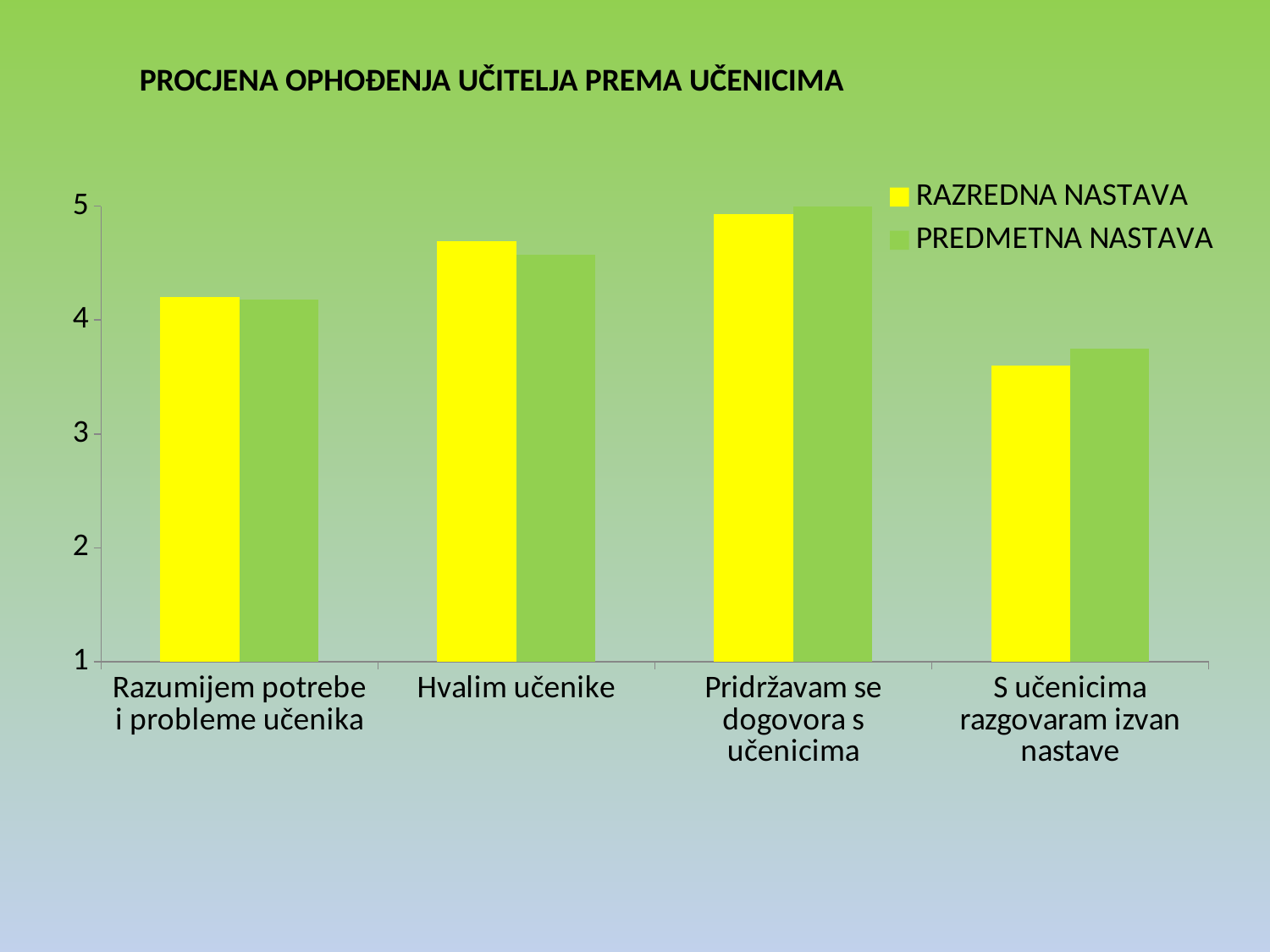
For 'S učenicima razgovaram izvan nastave', which series has the larger value, RAZREDNA NASTAVA or PREDMETNA NASTAVA? PREDMETNA NASTAVA For the RAZREDNA NASTAVA series, which category has the lowest value? S učenicima razgovaram izvan nastave How many categories are shown on the x axis of the chart? 4 How many series does the legend list? 2 For 'Hvalim učenike', which series has the larger value, RAZREDNA NASTAVA or PREDMETNA NASTAVA? RAZREDNA NASTAVA Which series is shown in yellow in the legend? RAZREDNA NASTAVA What kind of chart is shown on the slide? bar chart What is the title of the chart? PROCJENA OPHOĐENJA UČITELJA PREMA UČENICIMA For the RAZREDNA NASTAVA series, which category has the highest value? Pridržavam se dogovora s učenicima For the PREDMETNA NASTAVA series, which category has the highest value? Pridržavam se dogovora s učenicima Is the RAZREDNA NASTAVA value for 'S učenicima razgovaram izvan nastave' greater or less than 4? less For the PREDMETNA NASTAVA series, which category has the lowest value? S učenicima razgovaram izvan nastave